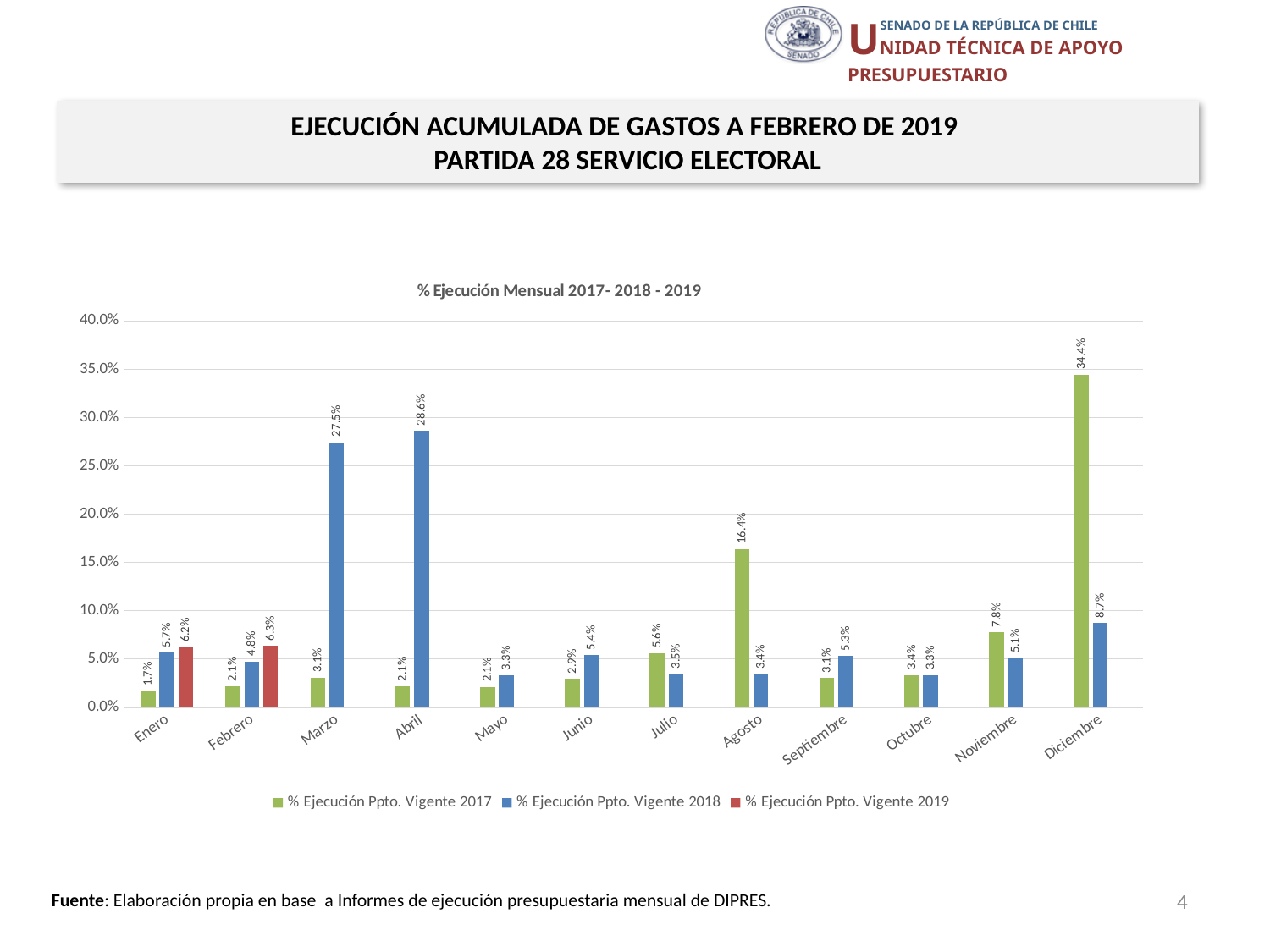
What is the value for % Ejecución Ppto. Vigente 2017 in Agosto? 16.4% How many months are shown on the x axis? 12 What kind of chart is shown on the slide? Bar chart In which month is the % Ejecución Ppto. Vigente 2018 series highest? Abril Which is larger in Noviembre, the 2017 value or the 2018 value? 2017 (7.8%) How many series does the legend list? 3 What is the difference between the 2018 and 2017 values in Abril? 26.5% Is the value for % Ejecución Ppto. Vigente 2017 in Diciembre greater or less than 30.0%? greater In which month is the % Ejecución Ppto. Vigente 2017 series highest? Diciembre What is the value for % Ejecución Ppto. Vigente 2018 in Marzo? 27.5% In which month is the % Ejecución Ppto. Vigente 2017 series lowest? Enero What is the value for % Ejecución Ppto. Vigente 2019 in Febrero? 6.3%